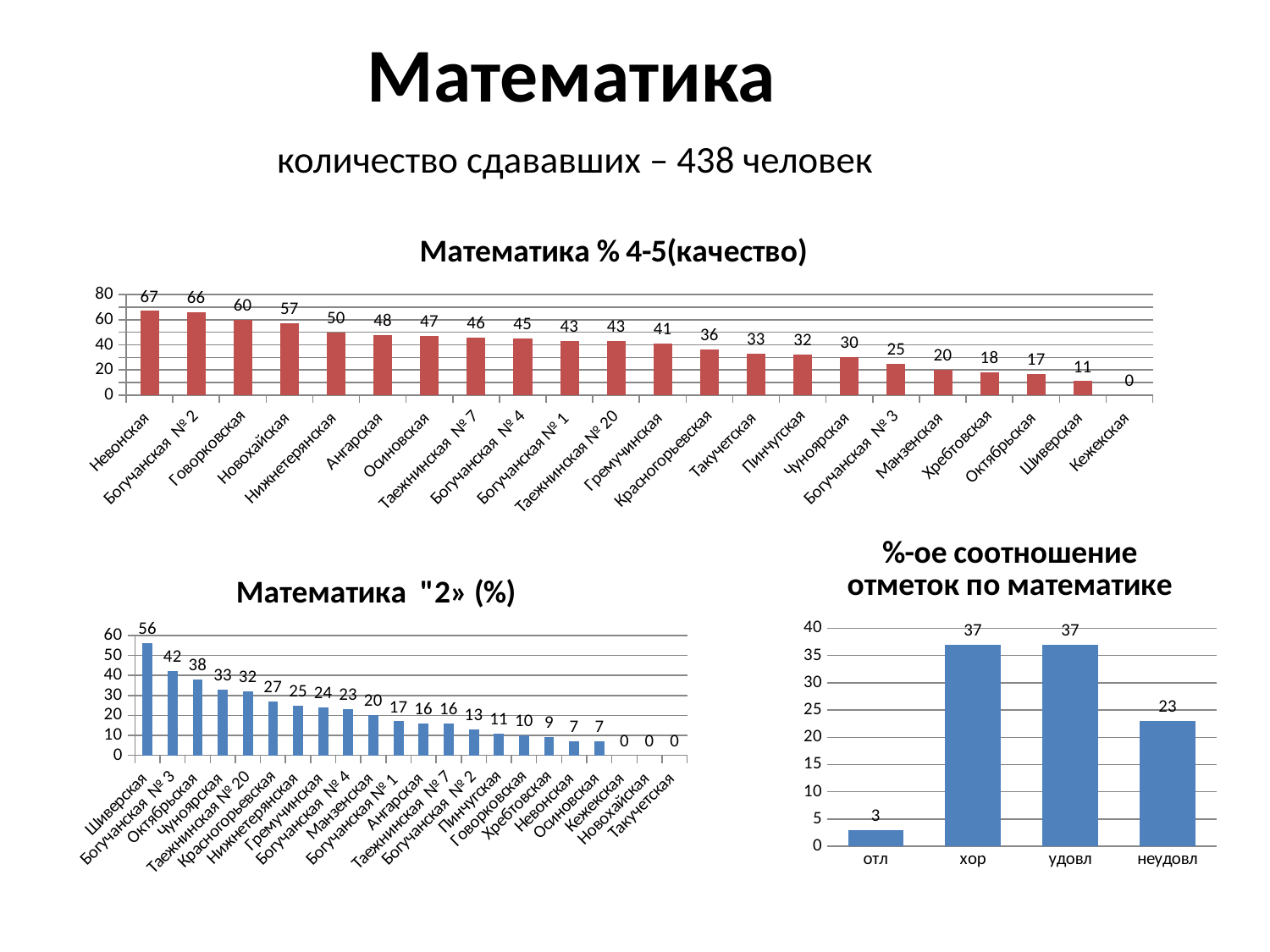
In the chart 'Математика % 4-5(качество)', how many categories are shown? 22 In the chart '%-ое соотношение отметок по математике', which category has the lowest value? отл In the chart 'Математика "2» (%)', what type of chart is used? bar chart In the chart '%-ое соотношение отметок по математике', what is the value for неудовл? 23 In the chart 'Математика % 4-5(качество)', do the values rise or fall from left to right? fall In the chart 'Математика % 4-5(качество)', what is the difference between Говорковская and Шиверская? 49 In the chart 'Математика % 4-5(качество)', what is the value for Невонская? 67 In the chart '%-ое соотношение отметок по математике', how many categories are shown? 4 In the chart 'Математика % 4-5(качество)', which category has the lowest value? Кежекская In the chart 'Математика "2» (%)', which is larger, Чуноярская or Манзенская? Чуноярская In the chart 'Математика "2» (%)', which category has the highest value? Шиверская In the chart 'Математика "2» (%)', what is the value for Октябрьская? 38